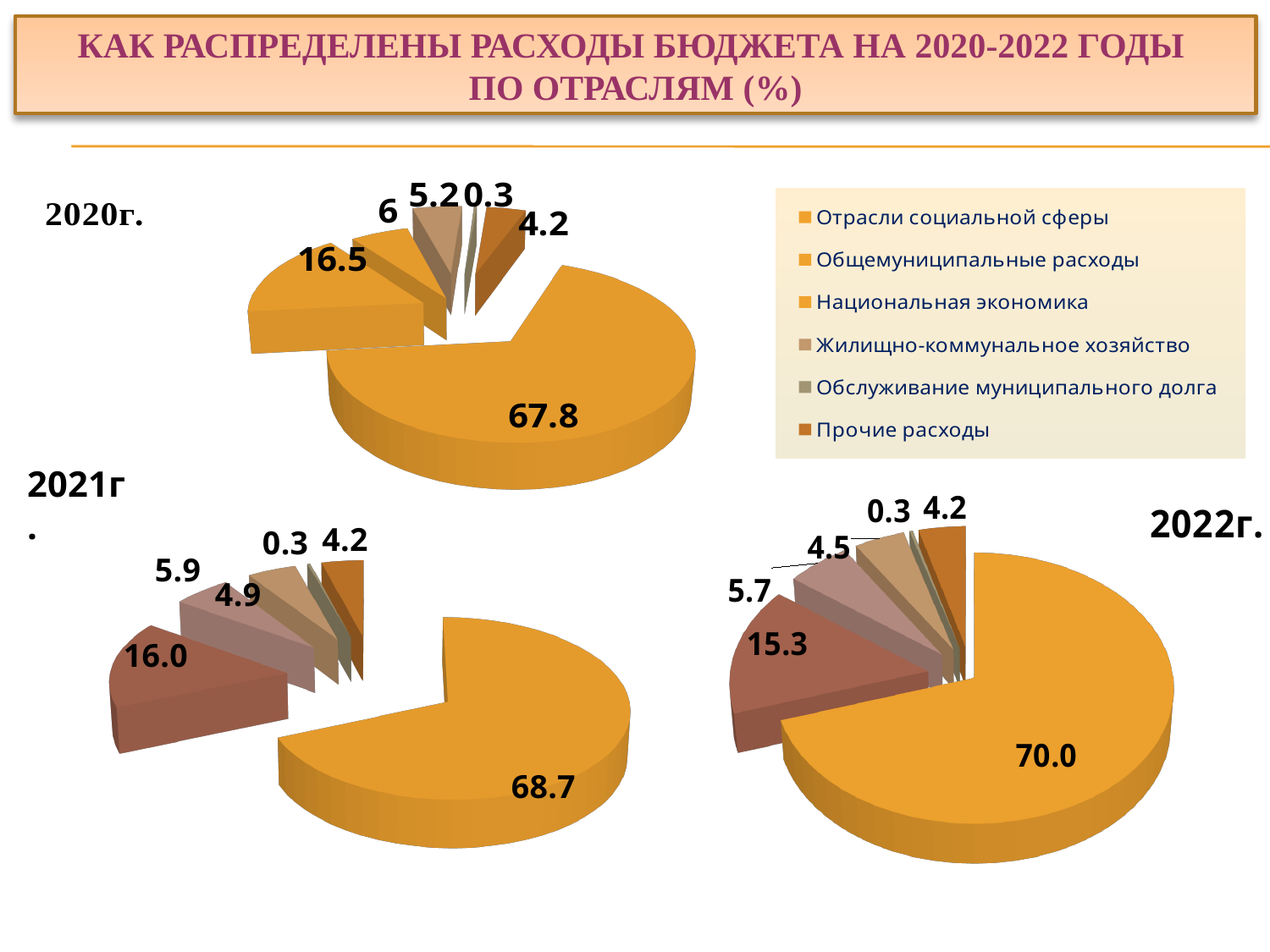
In the 2020 pie chart, what is the value of the largest slice? 67.8 In the 2022 pie chart, what is the second-largest labelled value? 15.3 What is the difference between the largest slice in the 2022 pie chart (70.0) and the largest slice in the 2020 pie chart (67.8)? 2.2 Which is larger: the 16.5 slice in the 2020 pie chart or the 16.0 slice in the 2021 pie chart? The 16.5 slice in the 2020 pie chart In the 2020 pie chart, what is the smallest labelled value? 0.3 In the 2022 pie chart, what is the value of the largest slice? 70.0 What kind of charts are shown on the slide? Pie charts How many pie charts are on the slide? 3 Does the largest slice in the 2020, 2021 and 2022 pie charts rise or fall from 2020 to 2022? Rise Which legend entry corresponds to the largest slice in each pie chart? Отрасли социальной сферы How many categories does the legend list? 6 In the 2021 pie chart, what is the value of the largest slice? 68.7